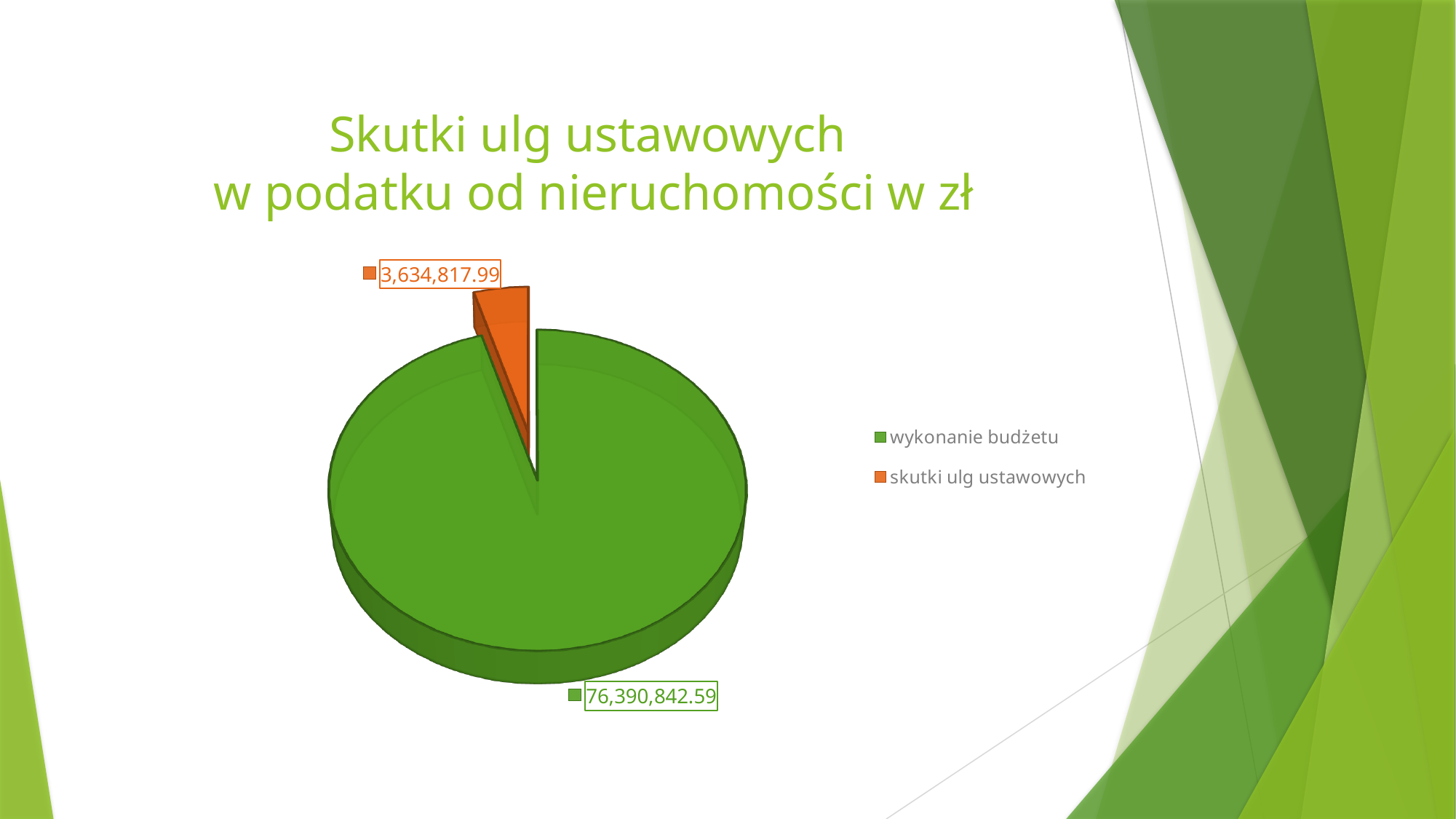
Which slice of the pie is the largest? wykonanie budżetu What colour is the slice for skutki ulg ustawowych? orange What is the difference between wykonanie budżetu and skutki ulg ustawowych? 72,756,024.60 What is the value for wykonanie budżetu? 76,390,842.59 How many slices does the pie chart have? 2 What is the value for skutki ulg ustawowych? 3,634,817.99 Which is larger, wykonanie budżetu or skutki ulg ustawowych? wykonanie budżetu How many entries does the legend list? 2 What is the title of the slide? Skutki ulg ustawowych w podatku od nieruchomości w zł What kind of chart is shown on the slide? pie chart What is the total of the two slices in the pie? 80,025,660.58 Which slice of the pie is the smallest? skutki ulg ustawowych